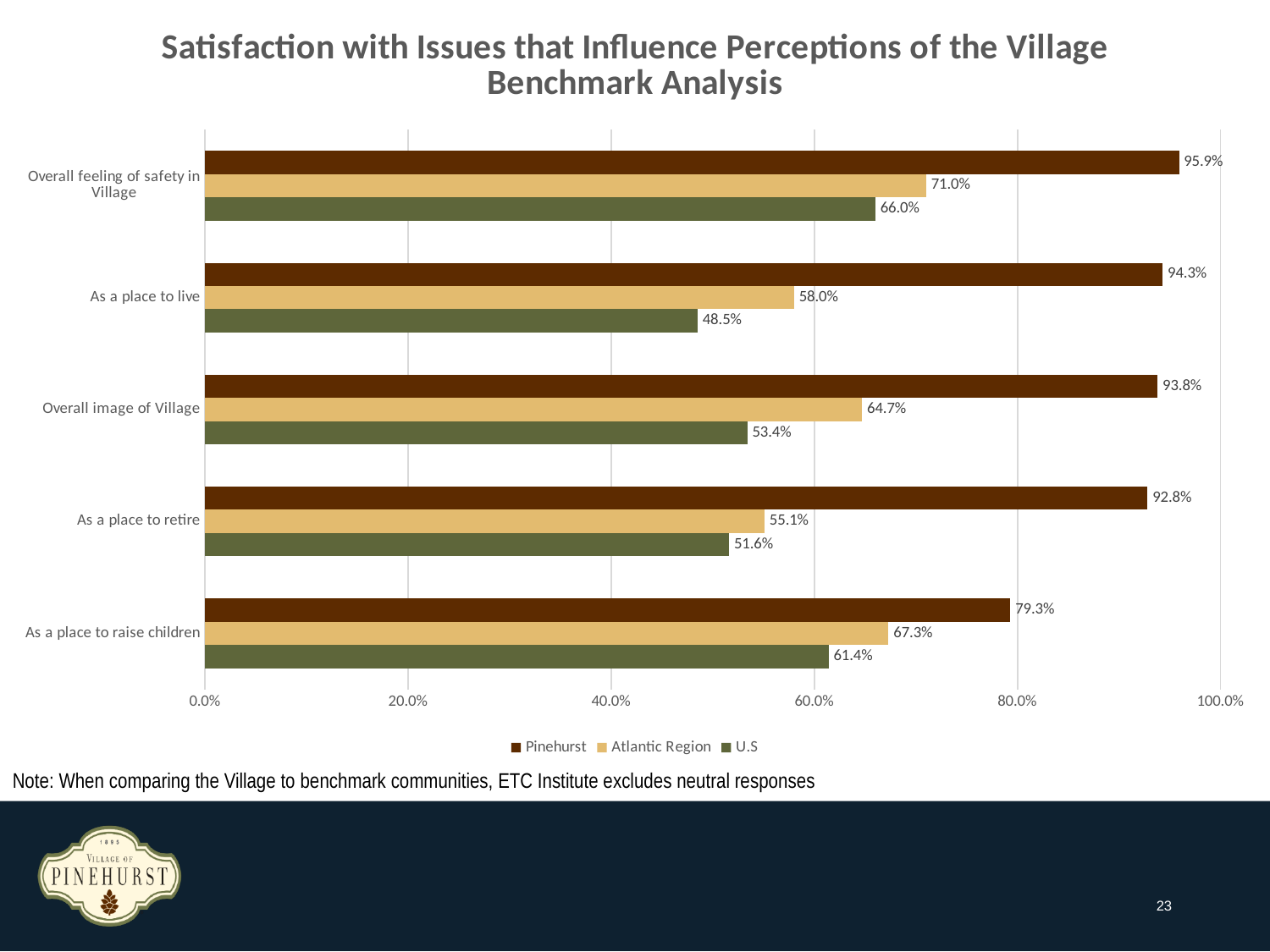
Is the Pinehurst value for "As a place to raise children" greater or less than 80.0%? less Which series is shown in the darkest brown colour? Pinehurst What is the difference between the Pinehurst and U.S values for "As a place to raise children"? 17.9% What is the Atlantic Region value for "As a place to retire"? 55.1% How many categories are shown on the chart? 5 Which category has the lowest U.S value? As a place to live How many series does the legend list? 3 What is the U.S value for "As a place to live"? 48.5% Which is larger for "Overall image of Village": the Atlantic Region value or the U.S value? Atlantic Region What kind of chart is shown on the slide? Bar chart What is the Pinehurst value for "Overall feeling of safety in Village"? 95.9% Which category has the highest Pinehurst value? Overall feeling of safety in Village